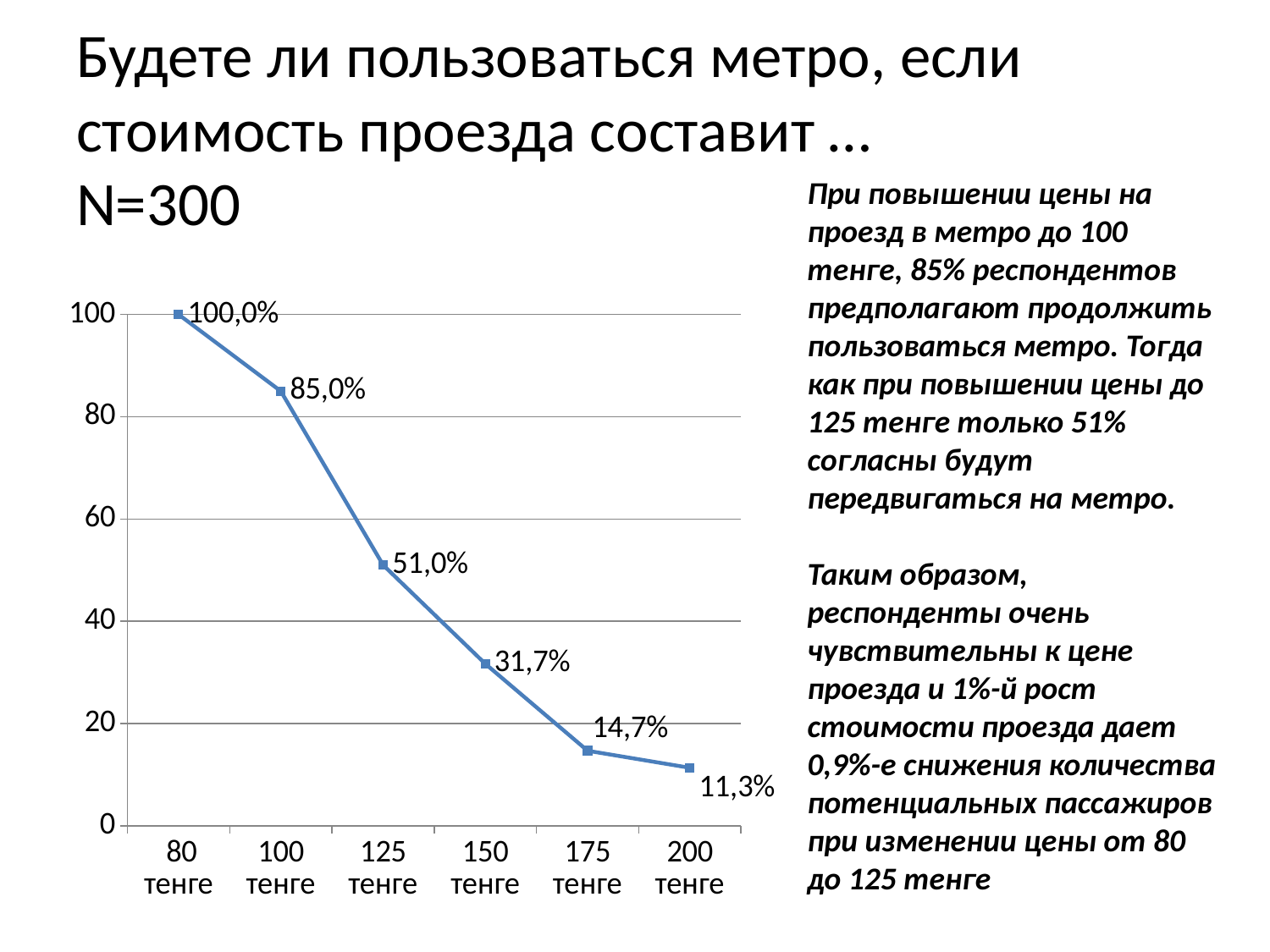
Which category has the highest value? 80 тенге What is the value for 200 тенге? 11,3% Which category has the lowest value? 200 тенге What is the value for 125 тенге? 51,0% Which is larger, the value for 150 тенге or the value for 175 тенге? 150 тенге What is the difference between the values for 175 тенге and 200 тенге? 3,4% What kind of chart is shown on the slide? line chart What is the value for 150 тенге? 31,7% How many categories are plotted on the x axis? 6 What is the difference between the values for 100 тенге and 125 тенге? 34,0% What is the value for 100 тенге? 85,0% Do the values rise or fall as the price increases along the x axis? fall